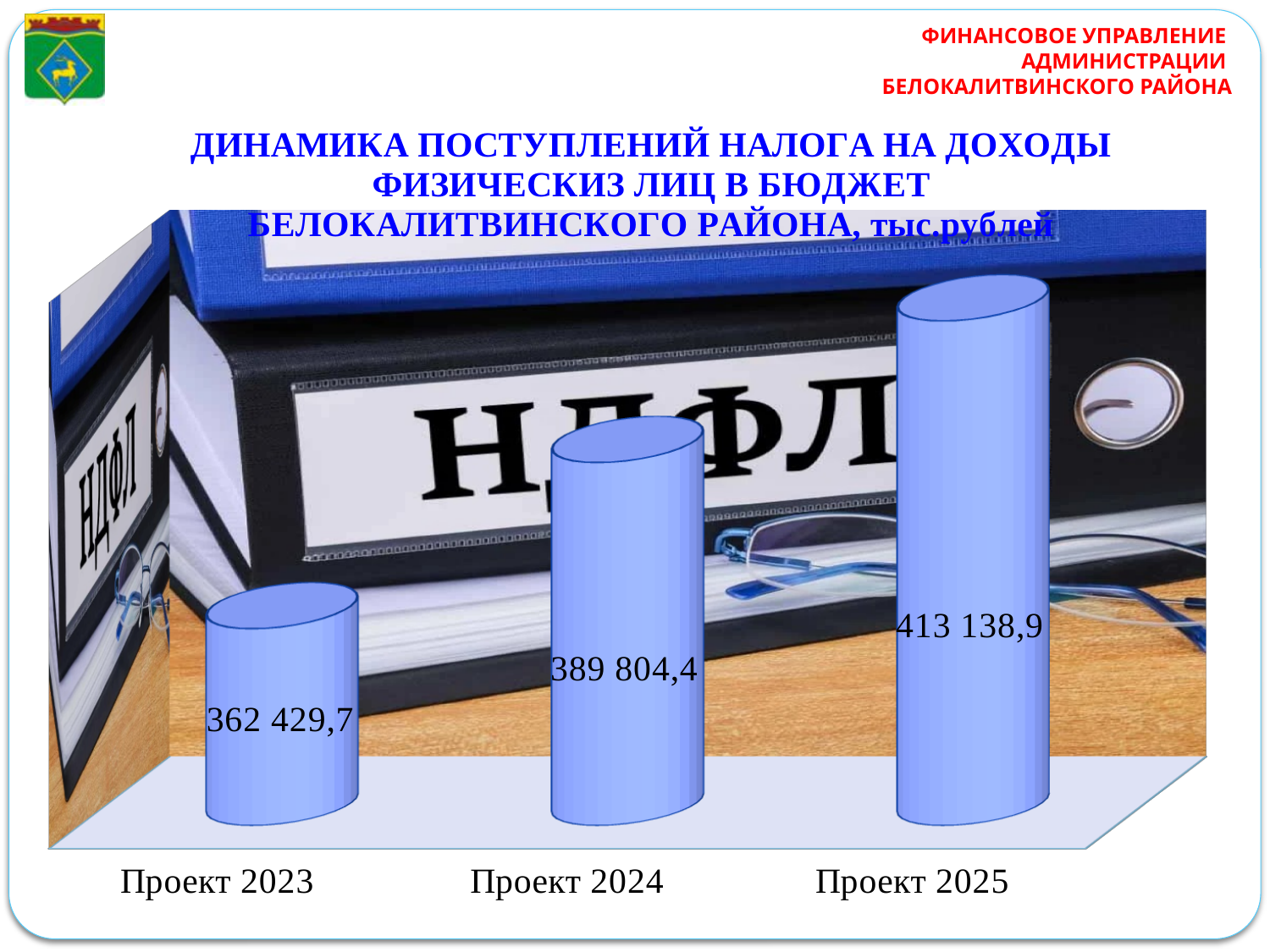
What is the value for Проект 2025? 413 138,9 What is the value for Проект 2023? 362 429,7 Which is larger, the value for Проект 2024 or Проект 2025? Проект 2025 What kind of chart is shown on the slide? Bar chart What is the difference between the values for Проект 2025 and Проект 2024? 23 334,5 What is the difference between the values for Проект 2024 and Проект 2023? 27 374,7 Which category has the highest value? Проект 2025 Do the values rise or fall from Проект 2023 to Проект 2025? Rise What is the value for Проект 2024? 389 804,4 How many categories are shown in the chart? 3 Which category has the lowest value? Проект 2023 What is the difference between the values for Проект 2025 and Проект 2023? 50 709,2